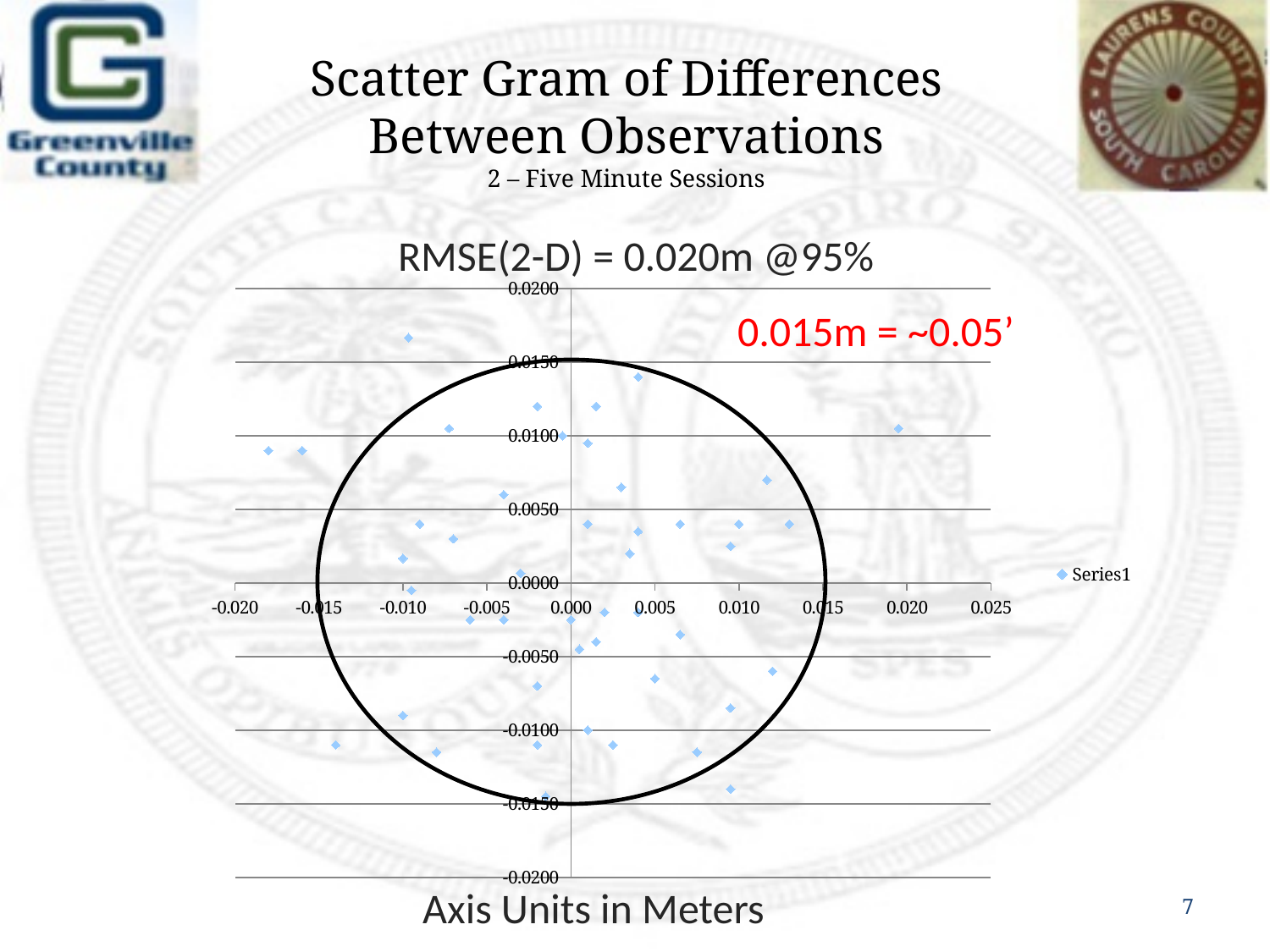
How many series does the chart legend list? 1 Is the y value of the highest point in the chart greater or less than 0.0150? greater Is the x value of the rightmost point in the chart greater or less than 0.015? greater What is the name of the series shown in the chart legend? Series1 Is the y value of the lowest point in the chart greater or less than -0.0100? less What kind of chart is shown on the slide? Scatter chart What is the title of the chart? RMSE(2-D) = 0.020m @95%